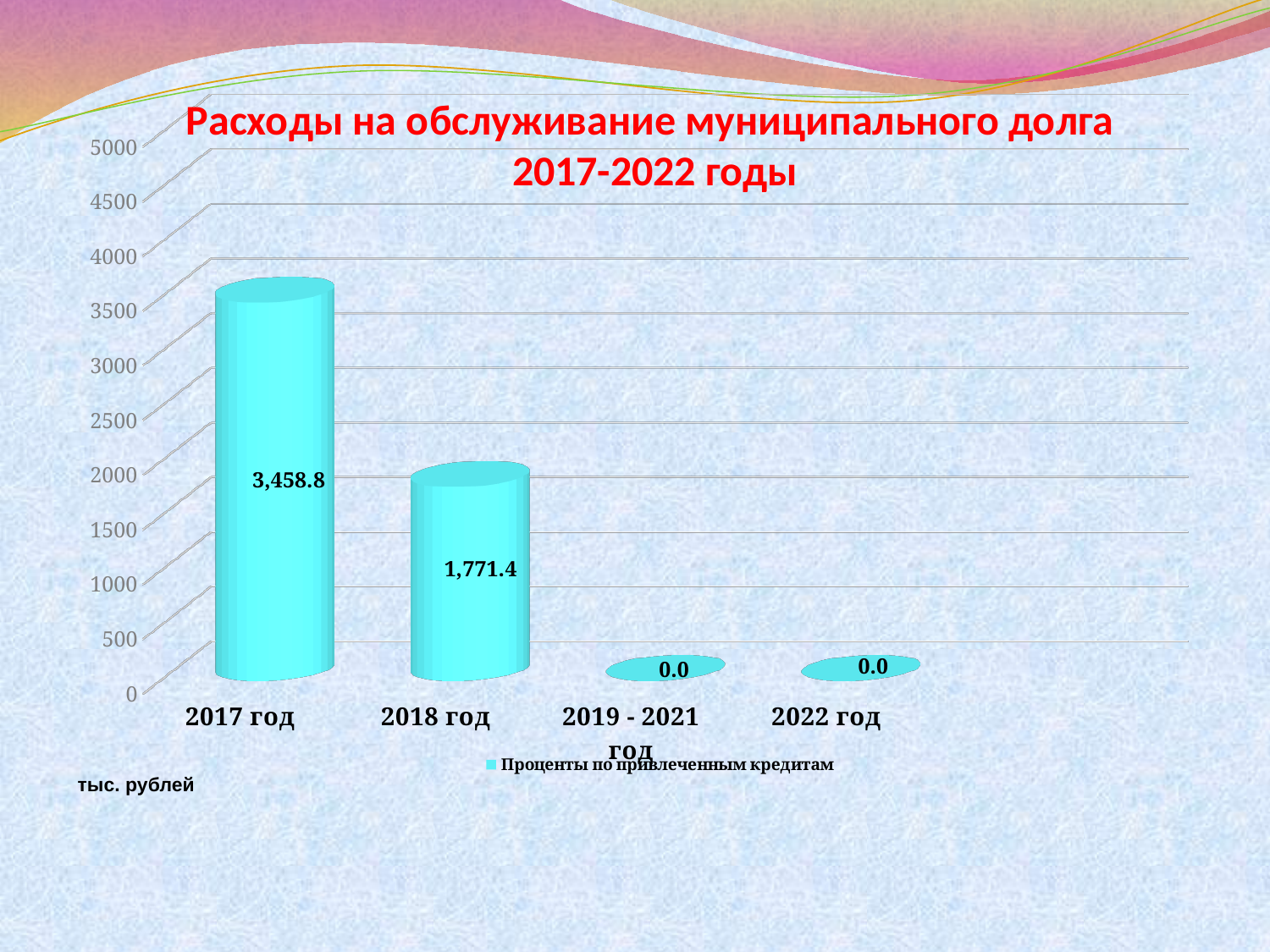
What kind of chart is shown on the slide? bar chart What is the value for 2017 год? 3,458.8 What is the value for 2018 год? 1,771.4 Which is larger, the value for 2017 год or the value for 2018 год? 2017 год Is the value for 2018 год greater or less than 2000? less How many series does the legend list? 1 What is the value for 2022 год? 0.0 What is the title of the chart? Расходы на обслуживание муниципального долга 2017-2022 годы Which category has the highest value? 2017 год What is the difference between the values for 2017 год and 2018 год? 1,687.4 What is the value for 2019 - 2021 год? 0.0 How many categories are shown on the x axis? 4